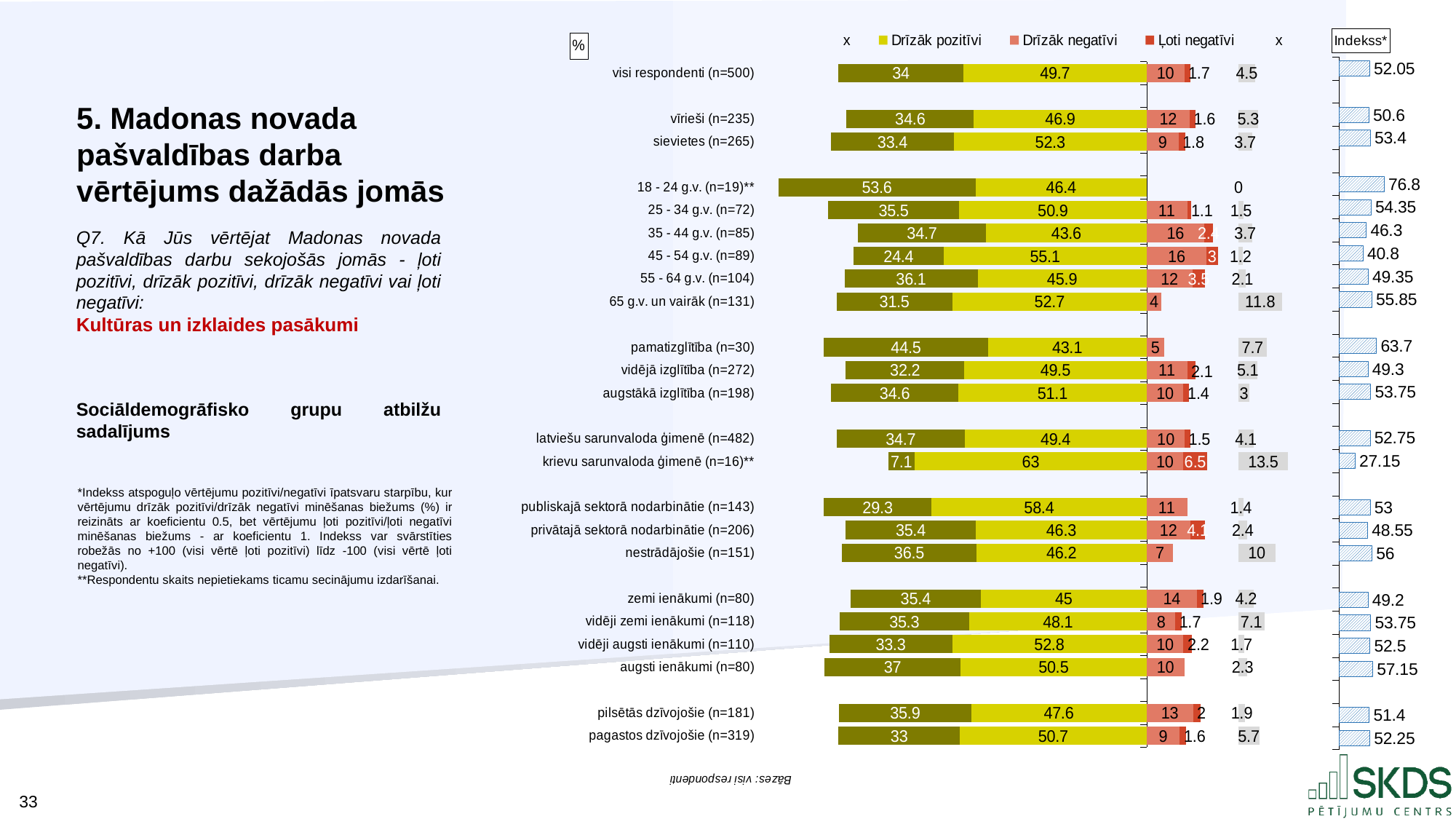
What is the Indekss value for 18 - 24 g.v. (n=19)**? 76.8 What is the difference between the "Drīzāk pozitīvi" values for sievietes (n=265) and vīrieši (n=235)? 5.4 What is the "Drīzāk pozitīvi" value for visi respondenti (n=500)? 49.7 What is the Indekss value for nestrādājošie (n=151)? 56 Which group has the highest Indekss value? 18 - 24 g.v. (n=19)** Which group has the lowest Indekss value? krievu sarunvaloda ģimenē (n=16)** What kind of chart is used to show the response shares? bar chart How many respondent groups are shown in the chart? 23 Which group has the highest "Drīzāk pozitīvi" value? krievu sarunvaloda ģimenē (n=16)** What is the "Drīzāk negatīvi" value for zemi ienākumi (n=80)? 14 What is the Indekss value for krievu sarunvaloda ģimenē (n=16)**? 27.15 Which has the larger Indekss value: pilsētās dzīvojošie (n=181) or pagastos dzīvojošie (n=319)? pagastos dzīvojošie (n=319)